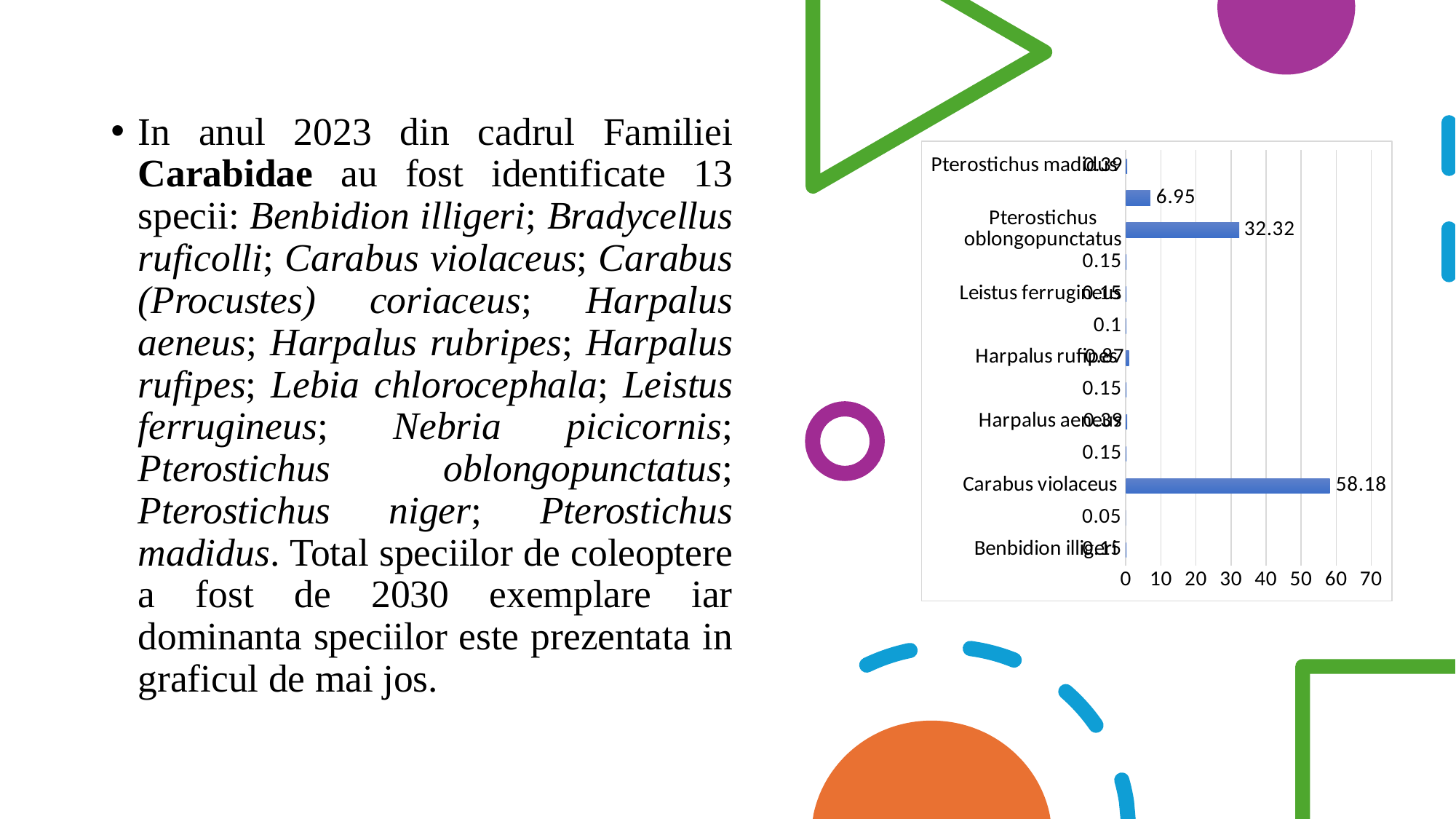
Are the bars in the chart horizontal or vertical? horizontal What is the highest value shown on the chart's value axis? 70 Is the value for Carabus violaceus greater or less than 50? greater Is the value for Pterostichus oblongopunctatus greater or less than 40? less Which is larger, the value for Carabus violaceus or the value for Pterostichus oblongopunctatus? Carabus violaceus Which species has the highest value in the chart? Carabus violaceus What kind of chart is shown on the slide? bar chart How many bars are plotted in the chart? 13 What is the value shown for Carabus violaceus? 58.18 What is the difference between the values for Carabus violaceus and Pterostichus oblongopunctatus? 25.86 What is the value shown for Pterostichus oblongopunctatus? 32.32